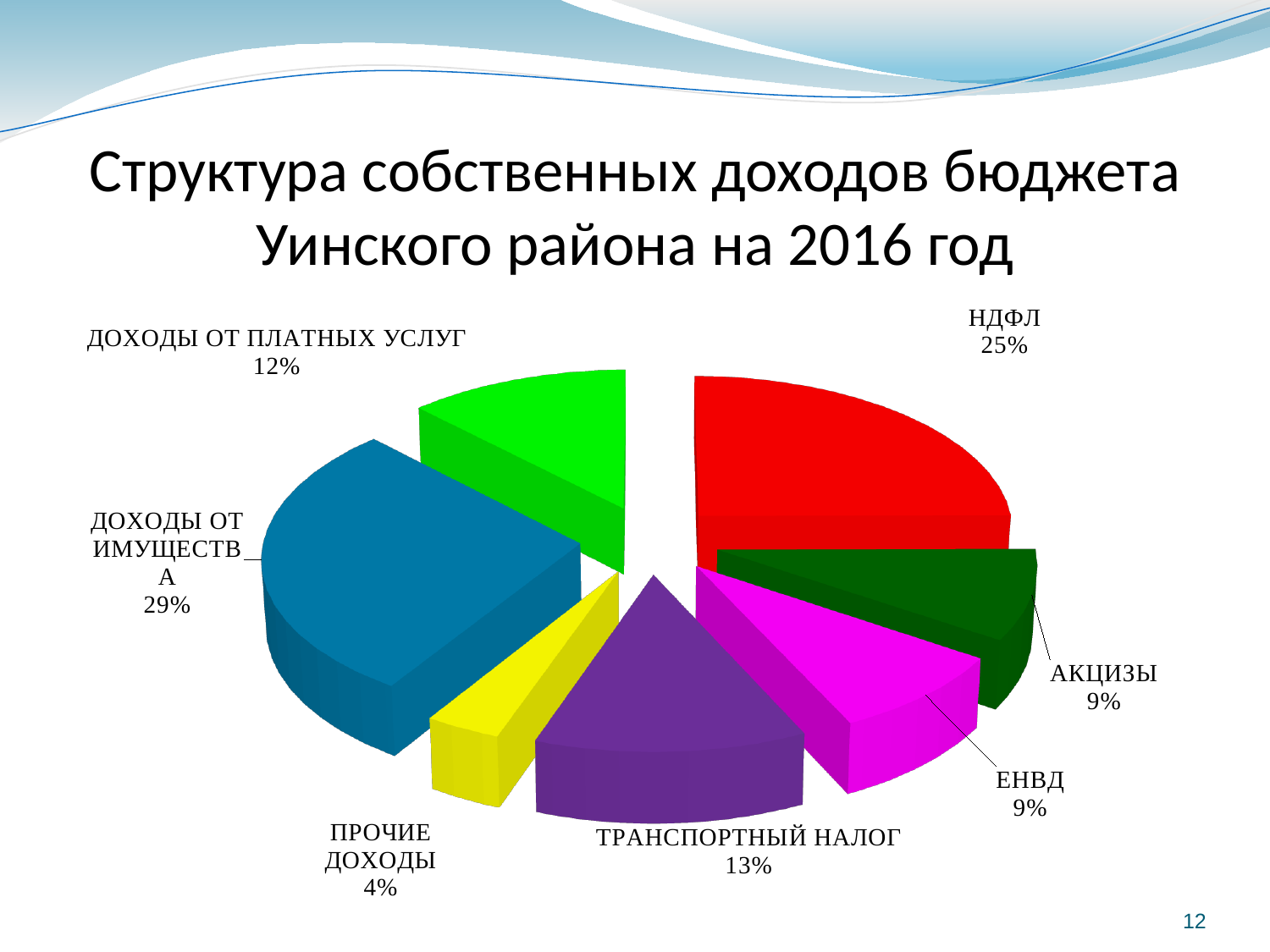
What share of the pie does НДФЛ represent? 25% What is the value labelled for ТРАНСПОРТНЫЙ НАЛОГ? 13% How many categories (slices) does the pie chart have? 7 What percentage is shown for ДОХОДЫ ОТ ИМУЩЕСТВА? 29% What is the difference in percentage points between ТРАНСПОРТНЫЙ НАЛОГ and ДОХОДЫ ОТ ПЛАТНЫХ УСЛУГ? 1 What is the difference in percentage points between ДОХОДЫ ОТ ИМУЩЕСТВА and НДФЛ? 4 What percentage is shown for ПРОЧИЕ ДОХОДЫ? 4% What type of chart is shown on the slide? Pie chart Which is larger, the share for НДФЛ or the share for ТРАНСПОРТНЫЙ НАЛОГ? НДФЛ Which category has the largest share of the pie? ДОХОДЫ ОТ ИМУЩЕСТВА What is the title of the chart on the slide? Структура собственных доходов бюджета Уинского района на 2016 год Which category has the smallest share of the pie? ПРОЧИЕ ДОХОДЫ